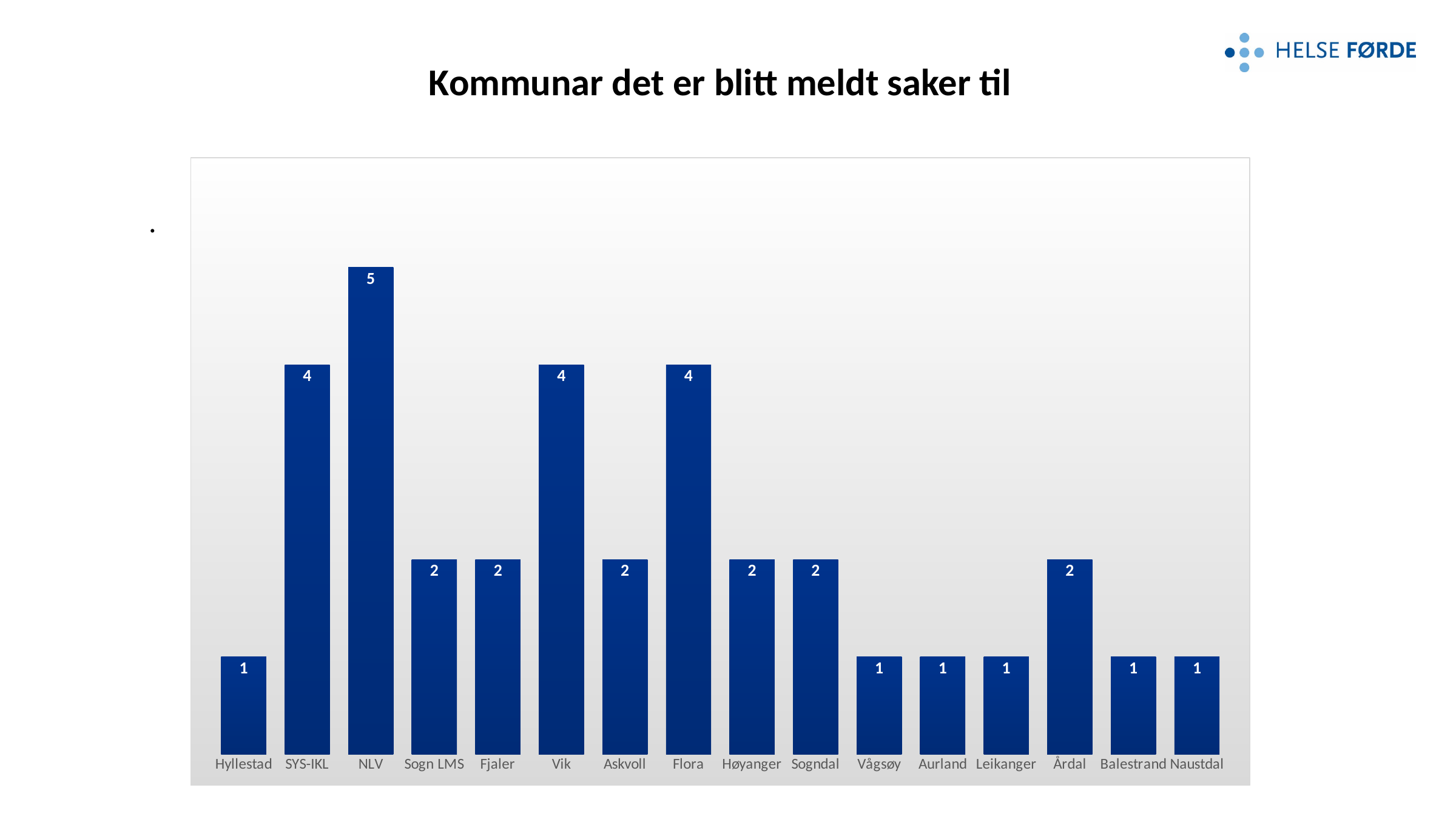
Which is larger, the value for Vik or the value for Askvoll? Vik What is the difference between the values for NLV and Hyllestad? 4 What is the value for Høyanger? 2 What is the difference between the values for SYS-IKL and Sogn LMS? 2 What is the title of the chart? Kommunar det er blitt meldt saker til What is the value for NLV? 5 Which is larger, the value for Årdal or the value for Vågsøy? Årdal How many categories are shown on the x axis of the chart? 16 What type of chart is shown on the slide? bar chart Which category has the highest value? NLV What is the value for Flora? 4 What is the value for Balestrand? 1